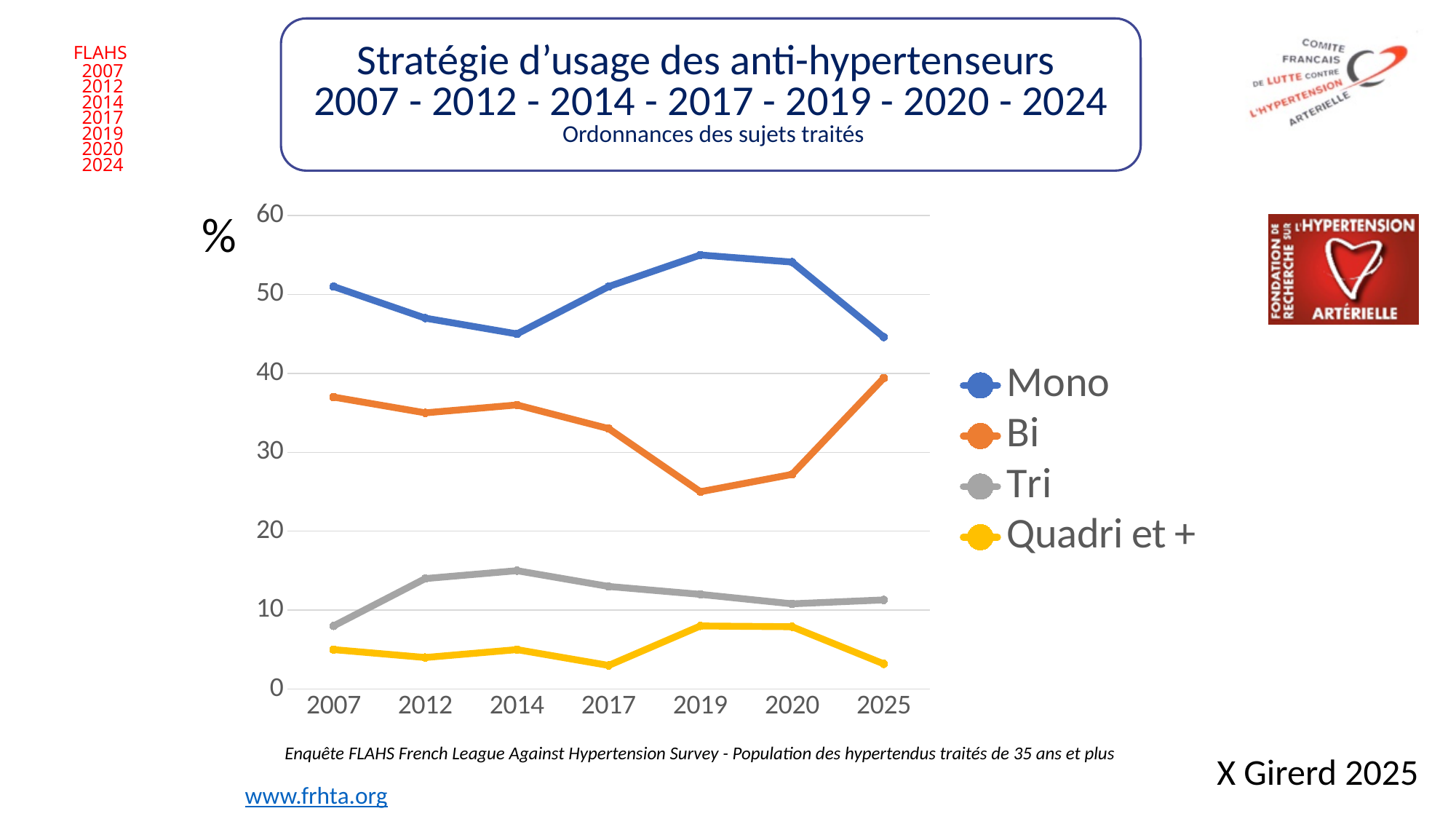
Which is larger: the Mono value in 2007 or the Mono value in 2025? 2007 Does the Bi series rise or fall from 2007 to 2019? fall In which year is the Tri series at its lowest? 2007 Which series has the highest value in 2025? Mono Is the value for Mono in 2019 greater or less than 50? greater How many series does the legend list? 4 Which series has the lowest values across all years? Quadri et + Is the value for Bi in 2019 greater or less than 30? less How many years are shown on the x axis? 7 What kind of chart is shown on the slide? line chart What colour is the Bi series in the legend? orange In which year is the Bi series at its lowest? 2019